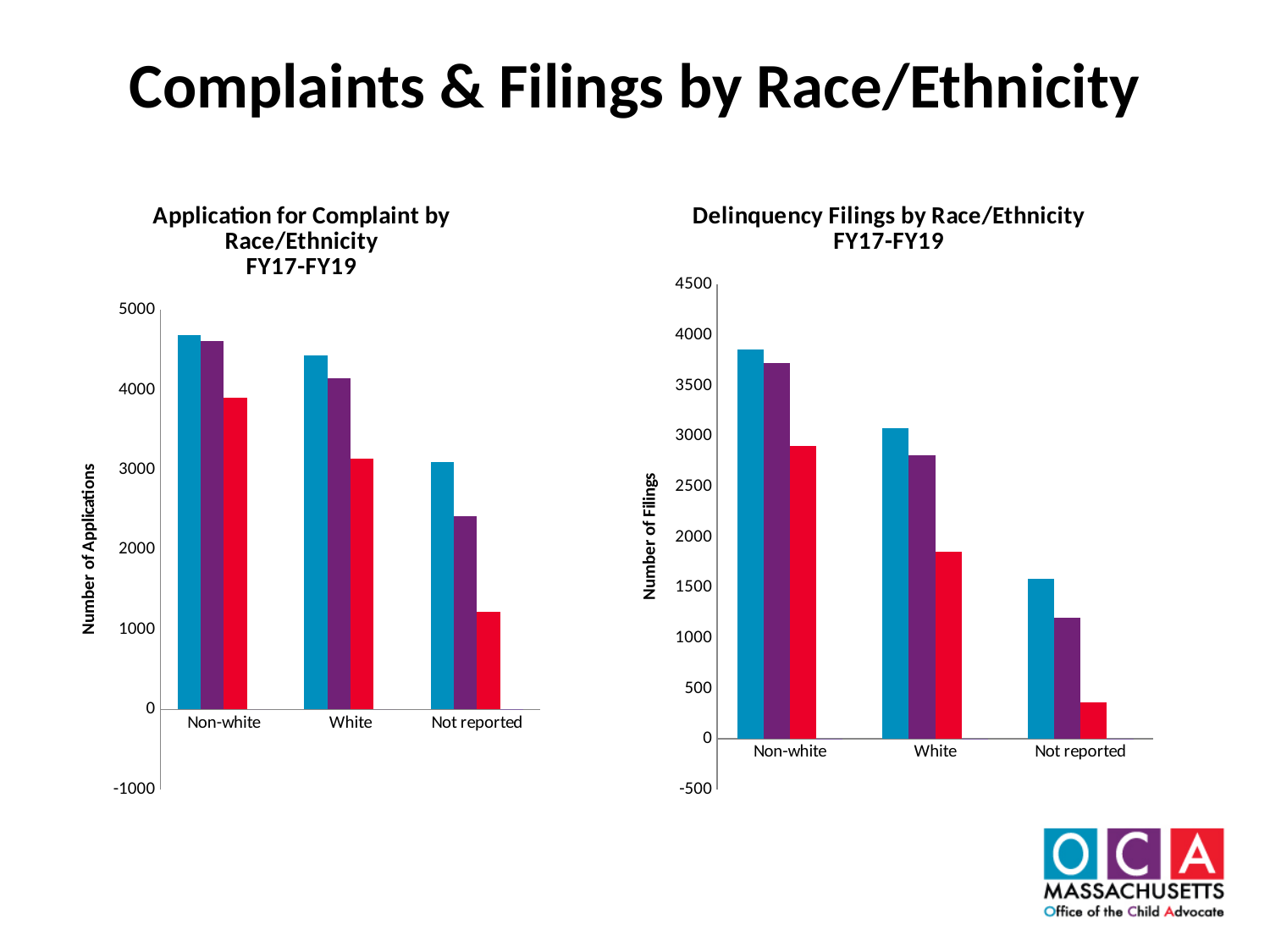
What is the y-axis label of the "Delinquency Filings by Race/Ethnicity FY17-FY19" chart? Number of Filings What kind of chart is the "Application for Complaint by Race/Ethnicity FY17-FY19" chart on the left? Bar chart What is the title of the chart on the left of the slide? Application for Complaint by Race/Ethnicity FY17-FY19 In the "Delinquency Filings by Race/Ethnicity FY17-FY19" chart, is the purple bar for White larger or smaller than the purple bar for Not reported? Larger In the "Application for Complaint by Race/Ethnicity FY17-FY19" chart, is the value of the blue bar for White greater or less than 4000? greater In the "Application for Complaint by Race/Ethnicity FY17-FY19" chart, is the value of the red bar for Not reported greater or less than 2000? less In the "Delinquency Filings by Race/Ethnicity FY17-FY19" chart, is the value of the red bar for Not reported greater or less than 500? less In the "Delinquency Filings by Race/Ethnicity FY17-FY19" chart, which category has the highest blue bar? Non-white In the "Application for Complaint by Race/Ethnicity FY17-FY19" chart, which category has the lowest red bar? Not reported In the "Application for Complaint by Race/Ethnicity FY17-FY19" chart, do the red bars rise or fall from Non-white to Not reported? Fall How many categories are shown on the x axis of the "Delinquency Filings by Race/Ethnicity FY17-FY19" chart? 3